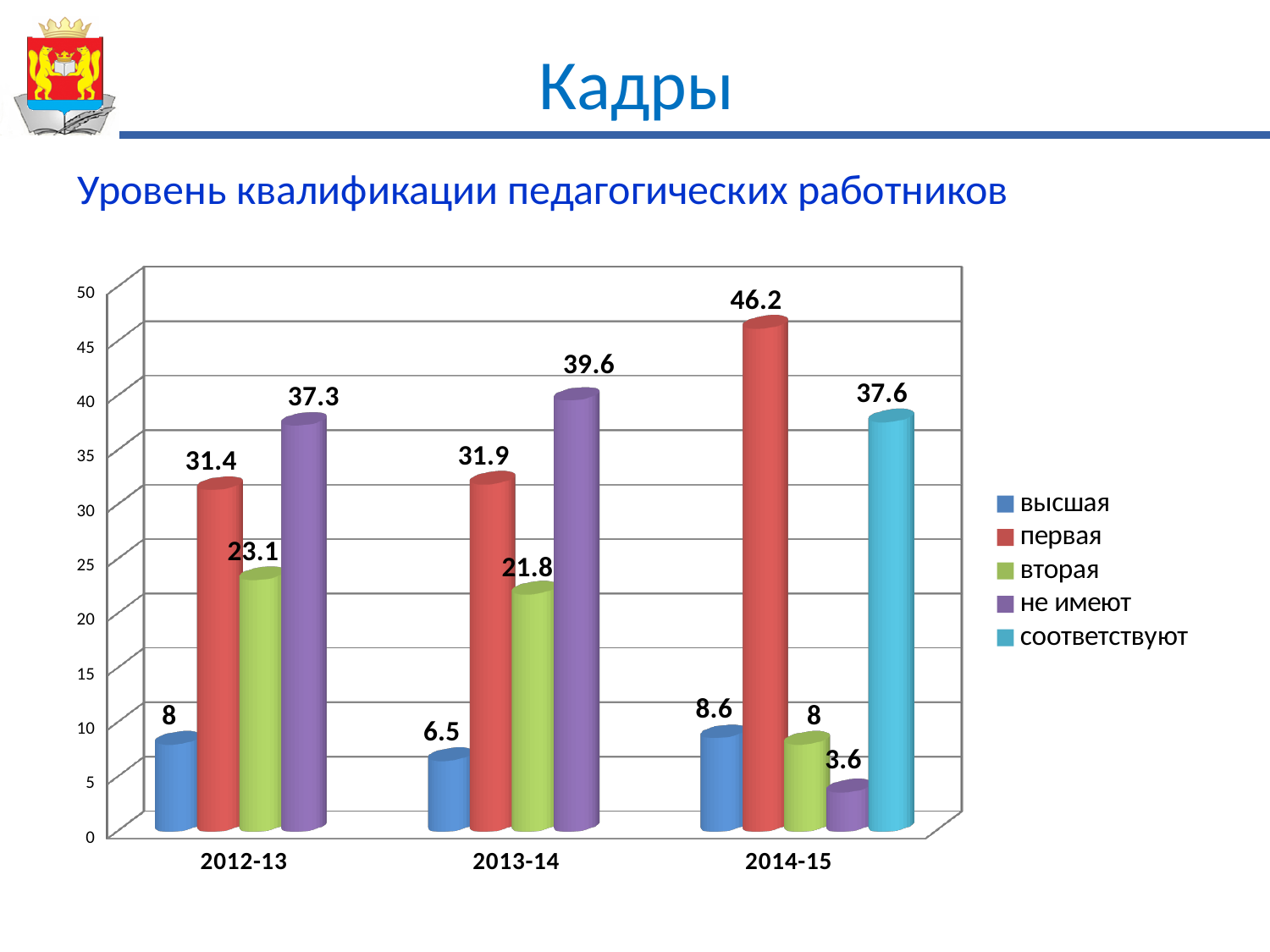
Which year has the lowest value for 'высшая'? 2013-14 Which year has the highest value for 'первая'? 2014-15 Which is larger: 'вторая' in 2012-13 or 'вторая' in 2013-14? 2012-13 Does the value for 'первая' rise or fall from 2012-13 to 2014-15? rise How many series does the legend list? 5 What is the value for 'соответствуют' in 2014-15? 37.6 What is the value for 'не имеют' in 2013-14? 39.6 What is the value for 'первая' in 2014-15? 46.2 What is the value for 'высшая' in 2012-13? 8 What kind of chart is shown on the slide? bar chart How many year categories are shown on the x axis? 3 What is the difference between the 'не имеют' values in 2013-14 and 2014-15? 36